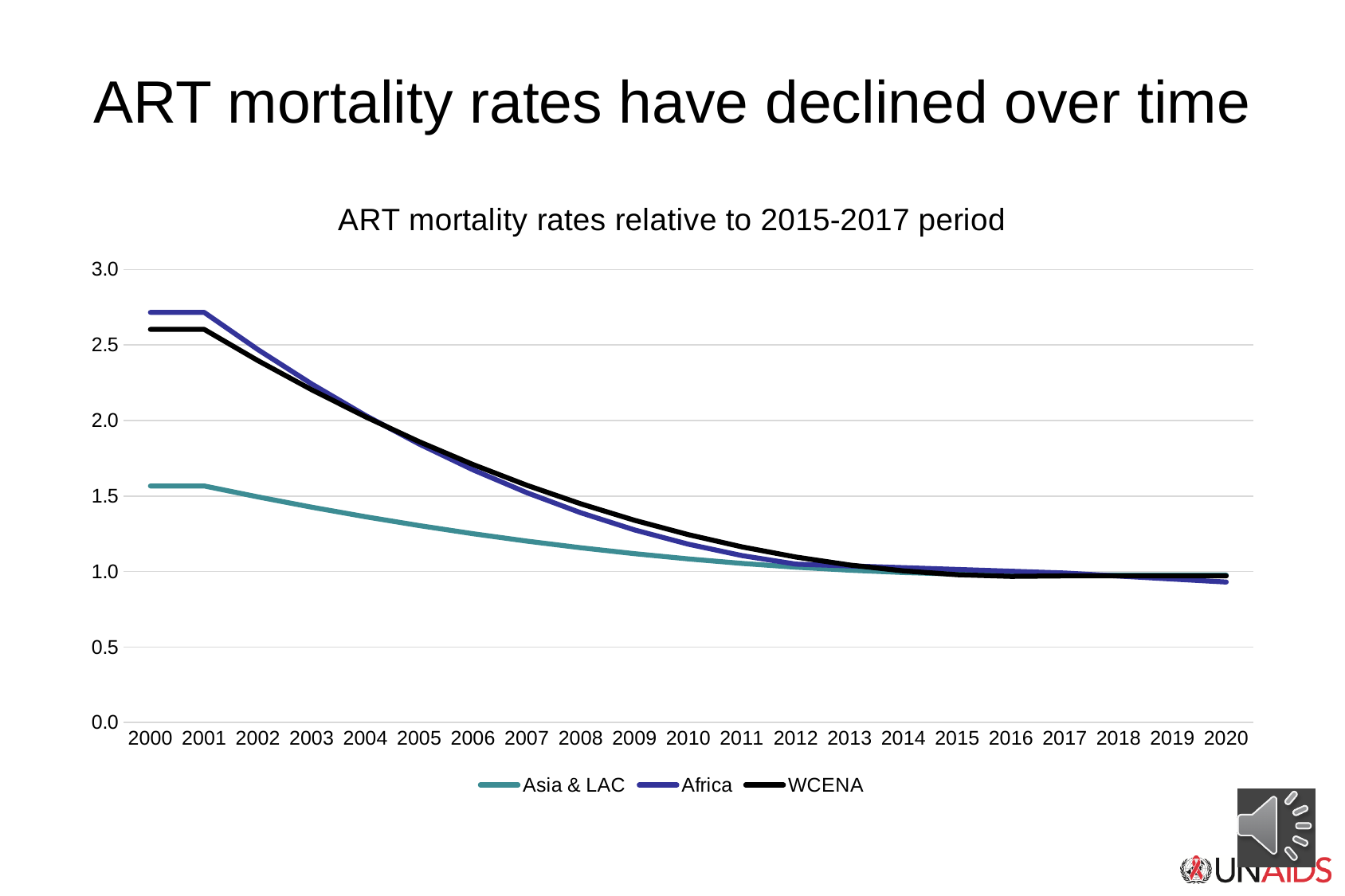
How many years are shown along the x axis? 21 Which series has the lowest value in 2000? Asia & LAC Which series has the highest value in 2000? Africa In 2005, which is larger: the value for Africa or the value for Asia & LAC? Africa Is the value for WCENA in 2010 greater or less than 1.5? less Is the value for Asia & LAC in 2000 greater or less than 2.0? less How many series does the legend list? 3 Is the value for Africa in 2000 greater or less than 2.5? greater Which series is drawn with a black line? WCENA What kind of chart is shown on the slide? line chart What is the title of the chart? ART mortality rates relative to 2015-2017 period Do the ART mortality rates rise or fall from 2000 to 2020? fall